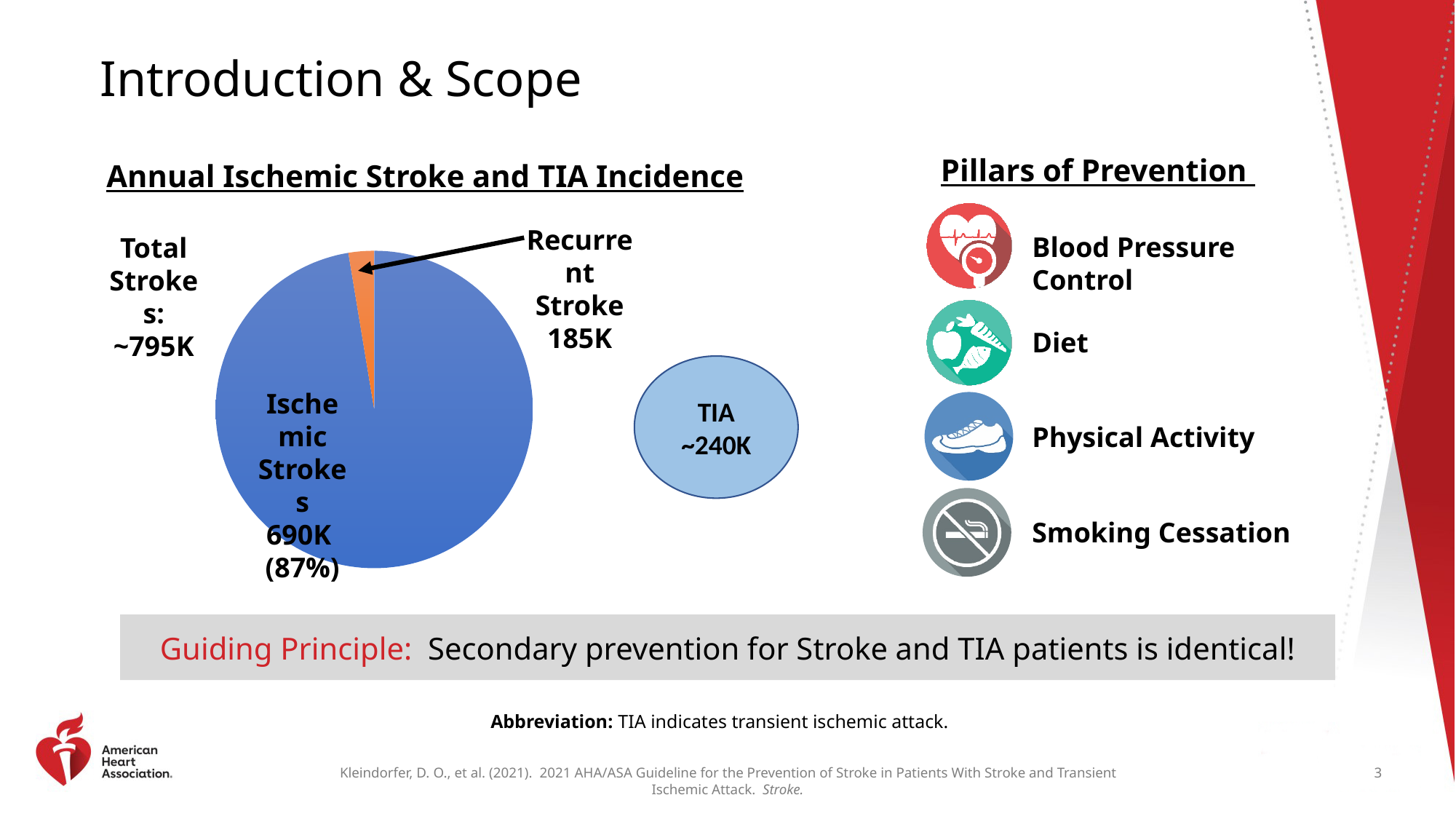
What is the difference between the Ischemic Strokes value and the Recurrent Stroke value in the pie chart? 505K What colour is the Recurrent Stroke slice in the pie chart? orange Which slice of the pie chart is the smallest? Recurrent Stroke Which slice of the pie chart is the largest? Ischemic Strokes In the pie chart, which is larger: Ischemic Strokes or Recurrent Stroke? Ischemic Strokes What is the title above the pie chart? Annual Ischemic Stroke and TIA Incidence What share of the pie chart do Ischemic Strokes represent? 87% In the pie chart, what value is shown for Ischemic Strokes? 690K What Total Strokes figure is printed next to the pie chart? ~795K How many slices does the pie chart have? 2 What kind of chart is shown under the title "Annual Ischemic Stroke and TIA Incidence"? pie chart In the pie chart, what value is shown for Recurrent Stroke? 185K